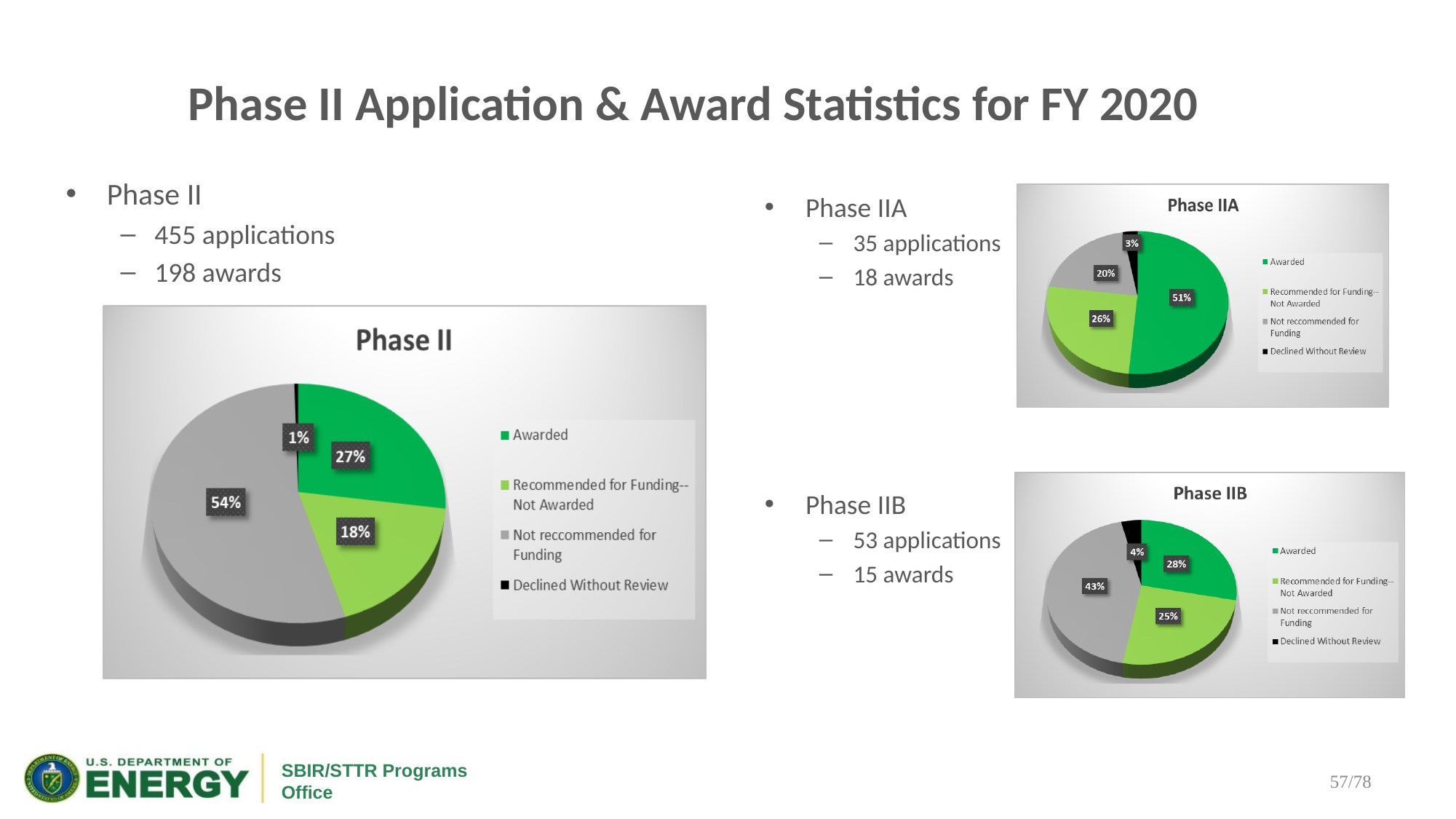
How many categories does the legend of the Phase II chart list? 4 What kind of chart is the Phase IIA chart? Pie chart In the Phase IIB chart, what percentage is Not recommended for Funding? 43% In the Phase IIB chart, what is the difference between the Not recommended for Funding slice and the Declined Without Review slice? 39% In the Phase II chart, what percentage is Not recommended for Funding? 54% In the Phase II chart, what share of the pie is Awarded? 27% In the Phase IIA chart, what percentage is Recommended for Funding--Not Awarded? 26% In the Phase II chart, which category has the smallest slice? Declined Without Review In the Phase II chart, what is the difference between the Not recommended for Funding slice and the Awarded slice? 27% In the Phase IIA chart, which category has the largest slice? Awarded In the Phase IIB chart, which is larger, the Awarded slice or the Recommended for Funding--Not Awarded slice? Awarded In the Phase IIA chart, what share of the pie is Awarded? 51%